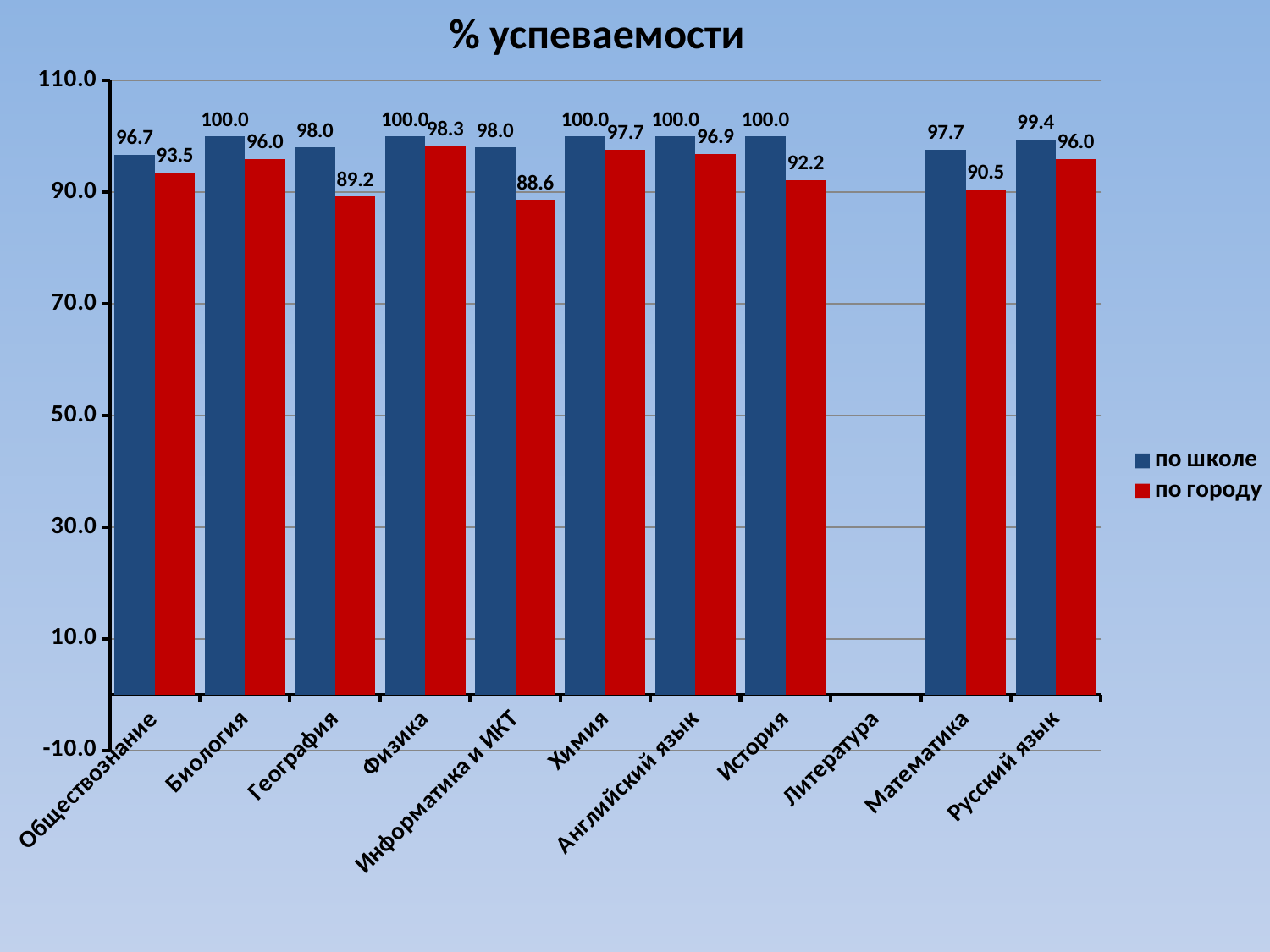
What is the value for Русский язык in the по школе series? 99.4 What is the value for География in the по городу series? 89.2 How many series does the legend list? 2 Which category has the highest value in the по городу series? Физика What is the difference between the по школе and по городу values for Математика? 7.2 Which category has the lowest value in the по городу series? Информатика и ИКТ What is the title of the chart? % успеваемости What is the difference between the по школе and по городу values for История? 7.8 What is the value for Обществознание in the по школе series? 96.7 How many categories are shown on the x axis? 11 Which is larger, the по городу value for Химия or the по городу value for Английский язык? Химия What kind of chart is shown on the slide? bar chart